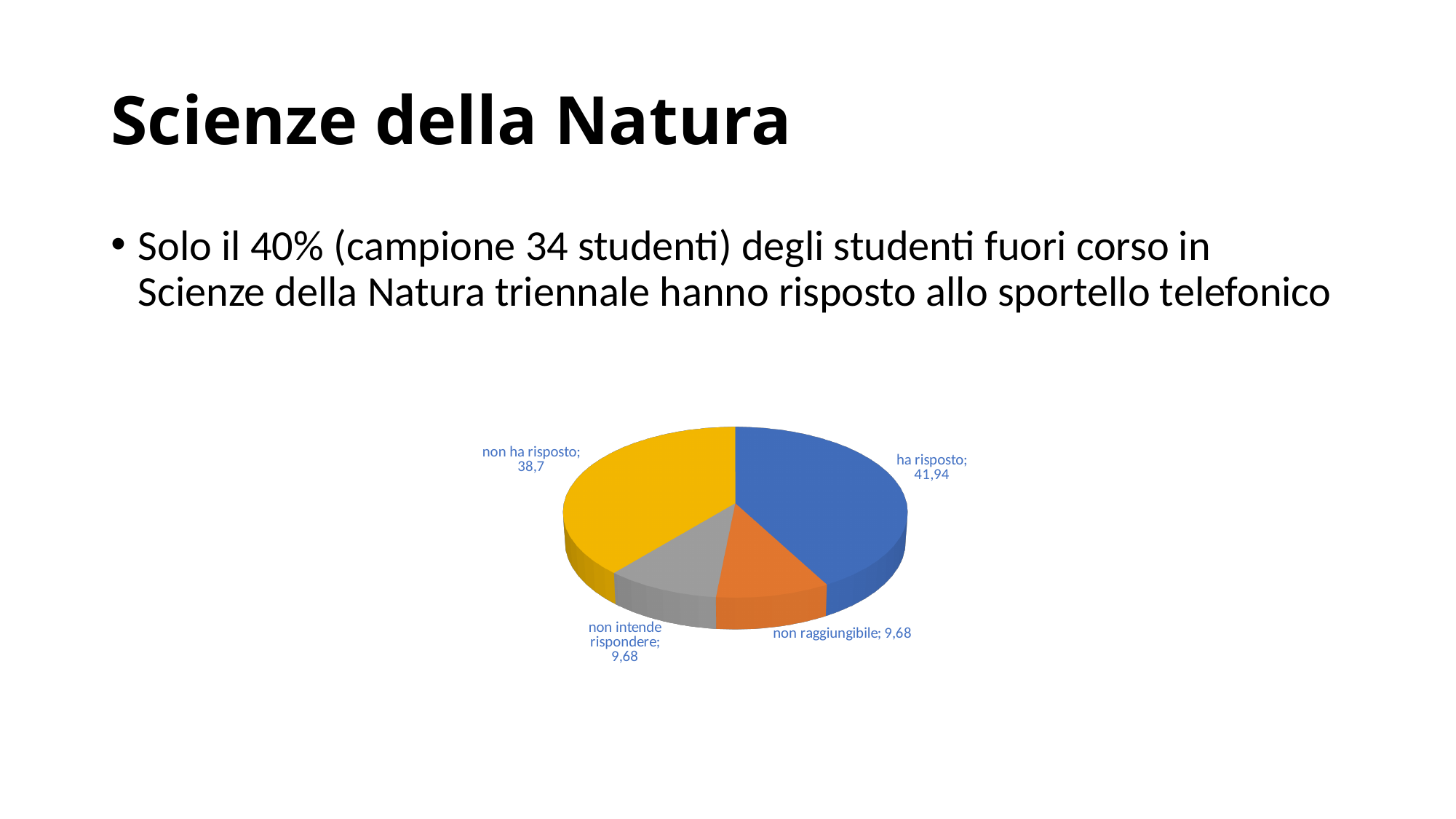
What is the difference between the values for "ha risposto" and "non ha risposto"? 3,24 What is the difference between the values for "non ha risposto" and "non raggiungibile"? 29,02 What value is shown for the "non intende rispondere" slice of the pie chart? 9,68 Which category has the largest slice in the pie chart? ha risposto How many slices does the pie chart have? 4 What value is shown for the "ha risposto" slice of the pie chart? 41,94 Which is larger, the value for "ha risposto" or the value for "non ha risposto"? ha risposto What value is shown for the "non ha risposto" slice of the pie chart? 38,7 What colour is the "non ha risposto" slice of the pie chart? yellow What value is shown for the "non raggiungibile" slice of the pie chart? 9,68 What colour is the "ha risposto" slice of the pie chart? blue What kind of chart is shown on the slide? pie chart